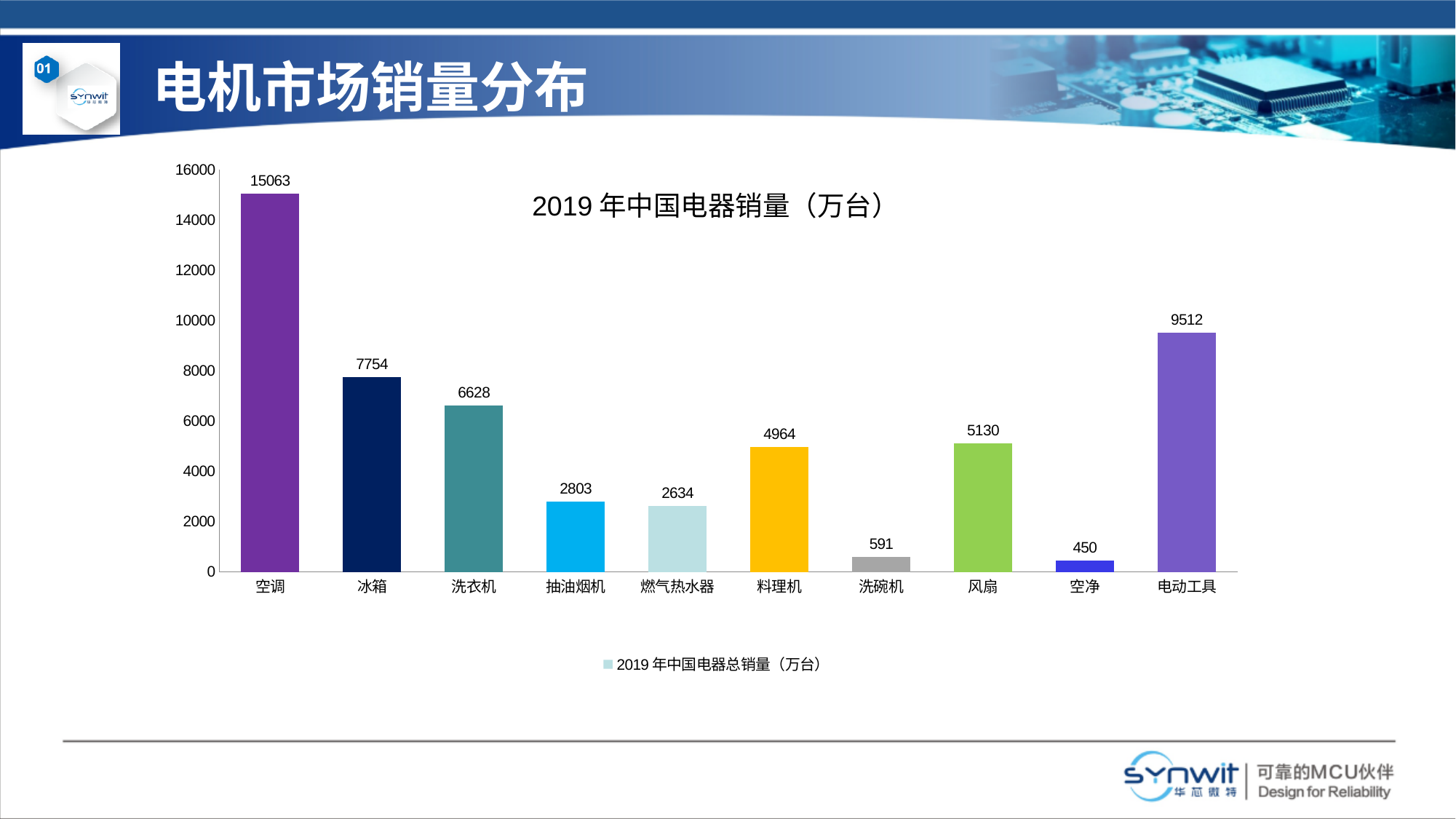
What is the value for 空调? 15063 What is the difference between the values for 冰箱 and 洗衣机? 1126 Which category has the highest value? 空调 Which category has the lowest value? 空净 Is the value for 抽油烟机 greater or less than 2000? greater What is the value for 电动工具? 9512 What is the title of the chart? 2019 年中国电器销量（万台） What is the value for 洗碗机? 591 What kind of chart is shown on the slide? bar chart How many categories are shown on the x axis? 10 How many series does the legend list? 1 Which is larger, the value for 风扇 or the value for 料理机? 风扇